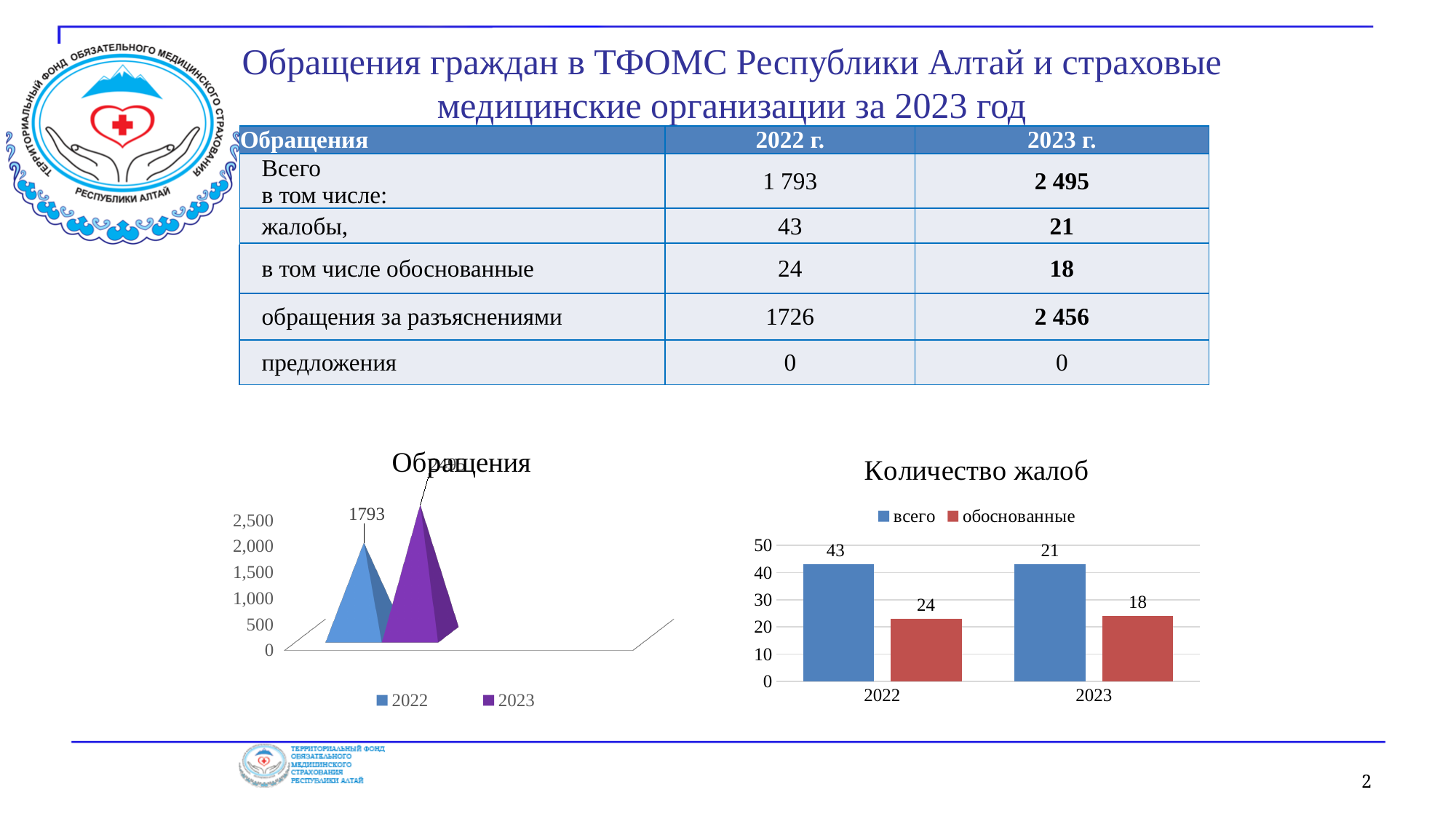
In the "Количество жалоб" chart, is the value of "обоснованные" for 2022 greater or less than 30? less How many series does the legend of the "Количество жалоб" chart list? 2 In the "Количество жалоб" chart, what is the value of "обоснованные" for 2023? 18 In the "Количество жалоб" chart, what data label is shown on the "всего" bar for 2023? 21 In the "Количество жалоб" chart, what is the value of "всего" for 2022? 43 In the "Количество жалоб" chart, what is the difference between "всего" and "обоснованные" for 2022? 19 In the "Обращения" chart, is the value for 2022 greater or less than 1,500? greater In the "Обращения" chart, what is the value for 2022? 1793 In the "Количество жалоб" chart, what is the value of "обоснованные" for 2022? 24 What kind of chart is "Количество жалоб"? bar chart How many series does the legend of the "Обращения" chart list? 2